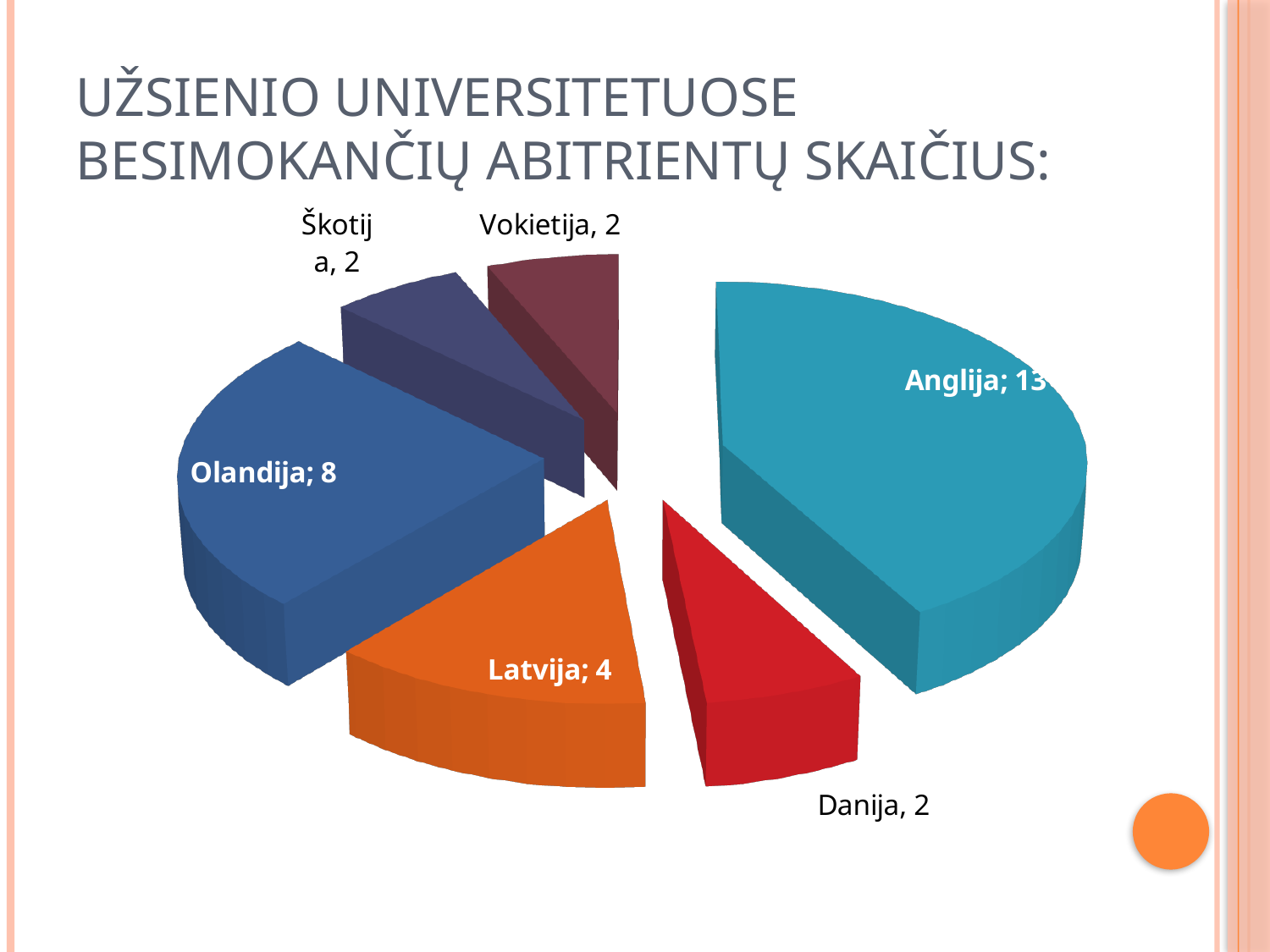
What is the total of all the values shown in the pie chart? 31 What is the difference between the values for Olandija and Latvija? 4 What is the value for Anglija? 13 What is the difference between the values for Anglija and Olandija? 5 How many slices does the pie chart have? 6 What colour is the slice for Anglija? teal What kind of chart is shown on the slide? pie chart What is the value for Latvija? 4 Which country has the largest slice of the pie? Anglija What is the value for Olandija? 8 What is the value for Danija? 2 Which is larger, the value for Latvija or the value for Vokietija? Latvija